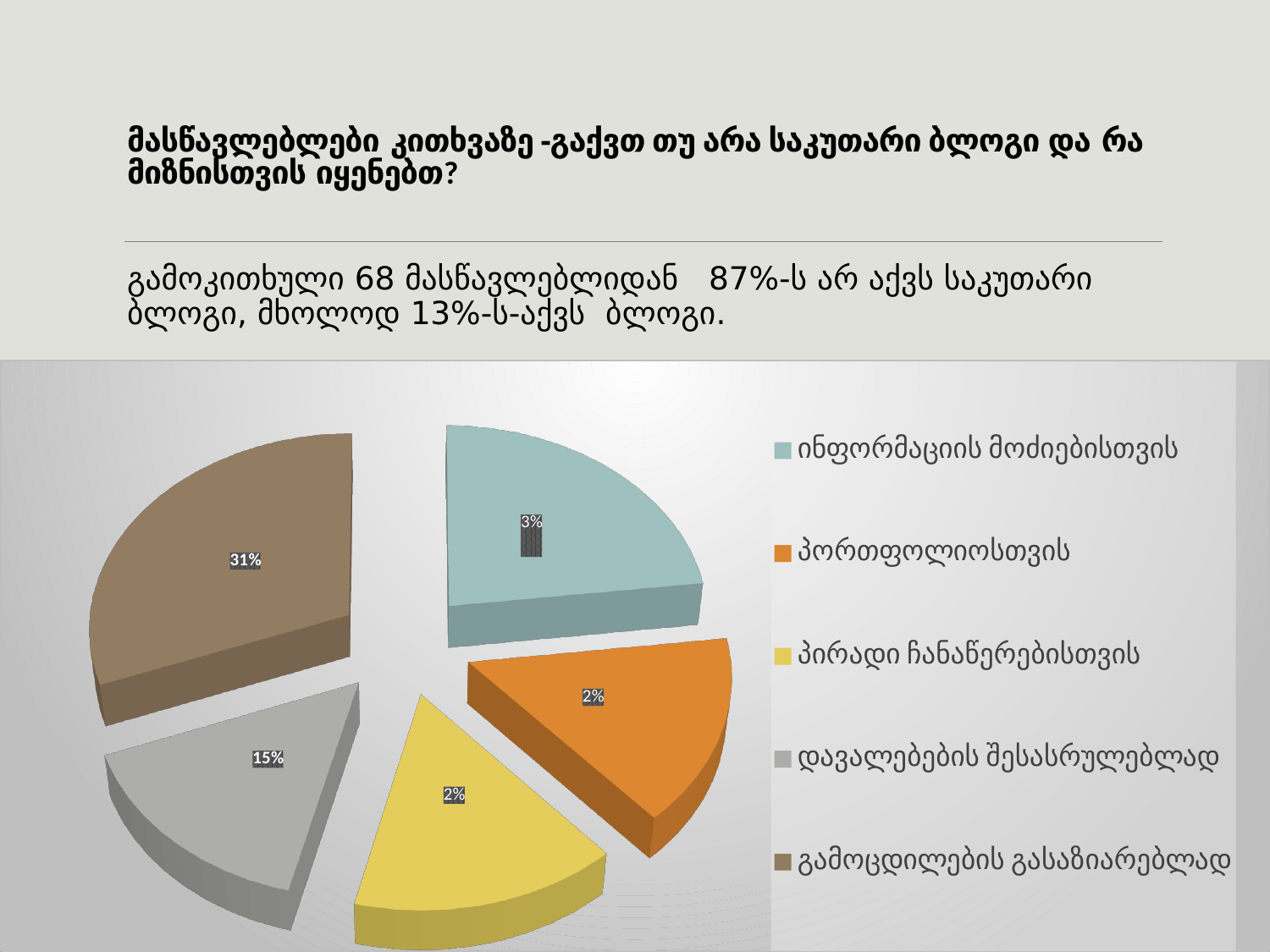
How many slices does the pie chart have? 5 What percentage is shown for the slice labelled პირადი ჩანაწერებისთვის? 2% How many entries does the legend list? 5 What percentage is shown for the slice labelled პორტფოლიოსთვის? 2% Which slice is larger: გამოცდილების გასაზიარებლად or დავალებების შესასრულებლად? გამოცდილების გასაზიარებლად What percentage is shown for the slice labelled ინფორმაციის მოძიებისთვის? 3% Which legend entry is shown in orange? პორთფოლიოსთვის What is the difference in percentage points between the გამოცდილების გასაზიარებლად slice and the დავალებების შესასრულებლად slice? 16 What kind of chart is shown on the slide? Pie chart Which category has the largest slice in the pie chart? გამოცდილების გასაზიარებლად What percentage is shown for the slice labelled დავალებების შესასრულებლად? 15% What percentage is shown for the slice labelled გამოცდილების გასაზიარებლად? 31%